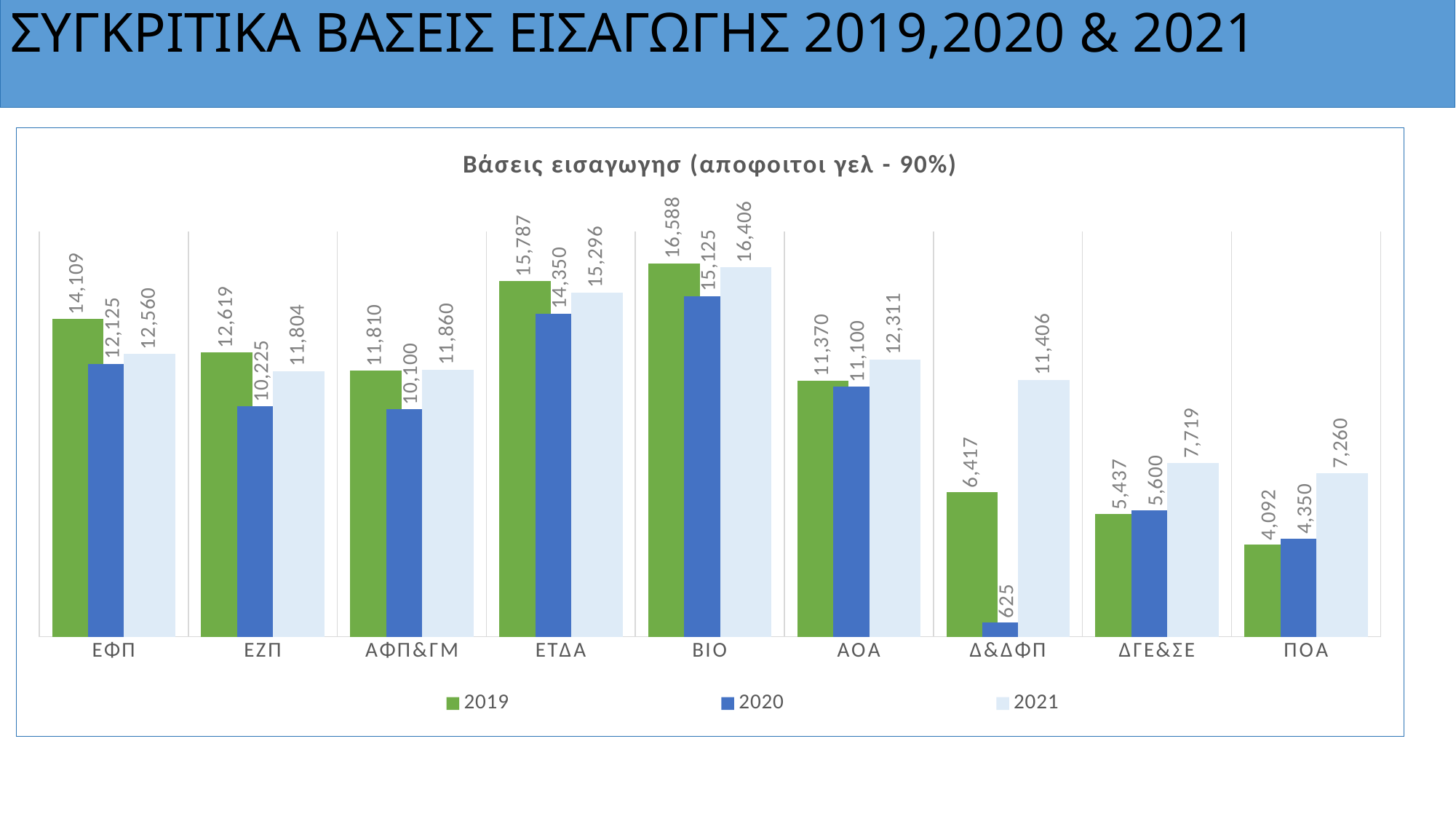
Which category has the highest 2019 value? ΒΙΟ What is the 2019 value for ΕΦΠ? 14,109 Which category has the lowest 2020 value? Δ&ΔΦΠ What is the difference between the 2021 and 2020 values for ΠΟΑ? 2,910 What kind of chart is shown on the slide? Bar chart What is the 2020 value for ΕΤΔΑ? 14,350 What is the title of the chart? Βάσεις εισαγωγησ (αποφοιτοι γελ - 90%) Which is larger for ΑΦΠ&ΓΜ, the 2019 value or the 2021 value? 2021 What is the 2021 value for Δ&ΔΦΠ? 11,406 How many series does the legend list? 3 How many categories are shown on the x axis? 9 What is the difference between the 2019 and 2020 values for ΕΖΠ? 2,394